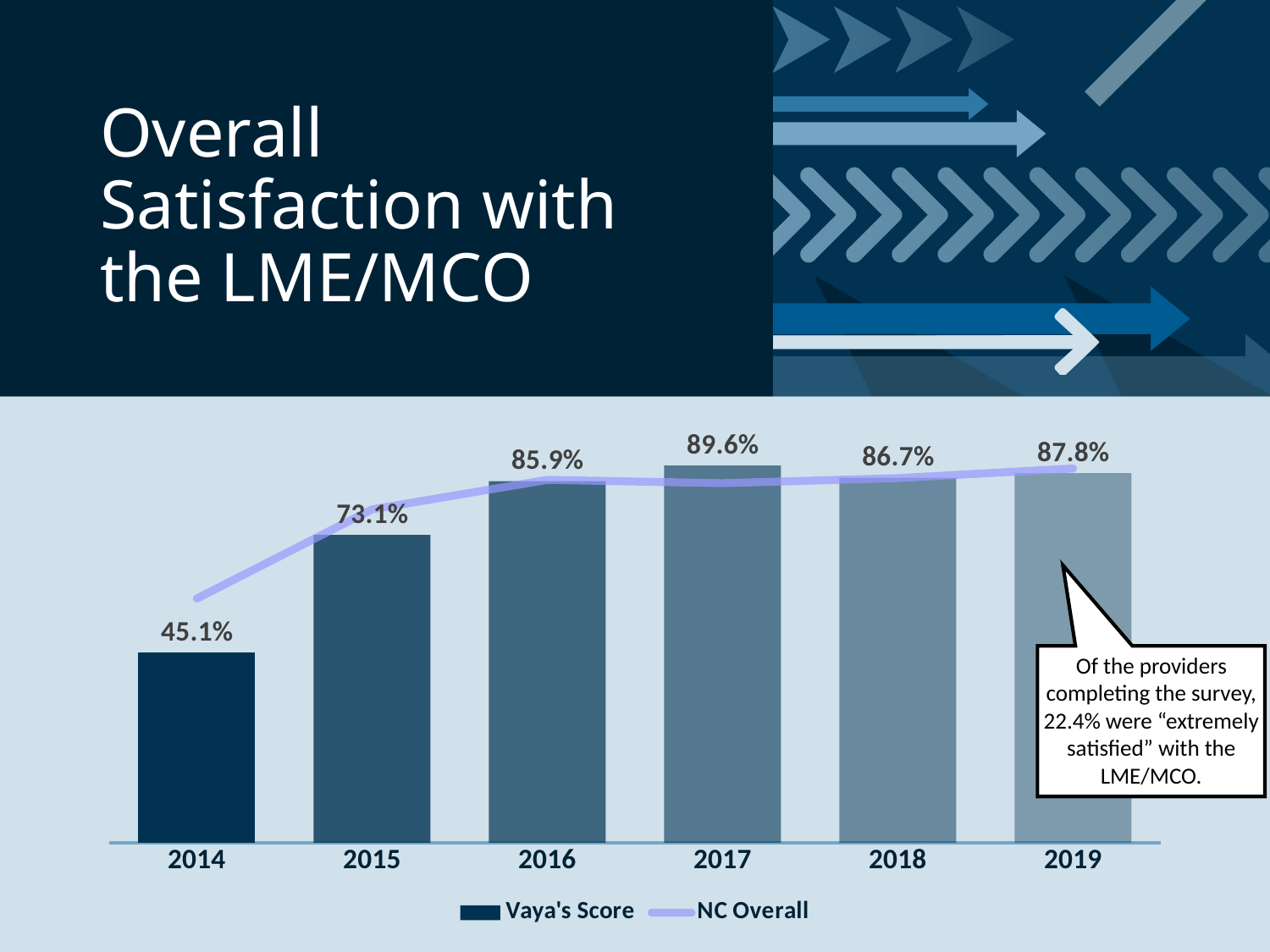
Does Vaya's Score rise or fall from 2014 to 2017? Rise Which is larger, Vaya's Score in 2016 or in 2018? 2018 What is the difference between Vaya's Score in 2015 and 2014? 28% Which year has the lowest Vaya's Score? 2014 What is Vaya's Score for 2014? 45.1% What is Vaya's Score for 2019? 87.8% Which year has the highest Vaya's Score? 2017 How many years are shown on the x axis? 6 What kind of chart is used to show Vaya's Score? Bar chart How many series does the legend list? 2 What is the difference between Vaya's Score in 2017 and 2018? 2.9% What is Vaya's Score for 2017? 89.6%